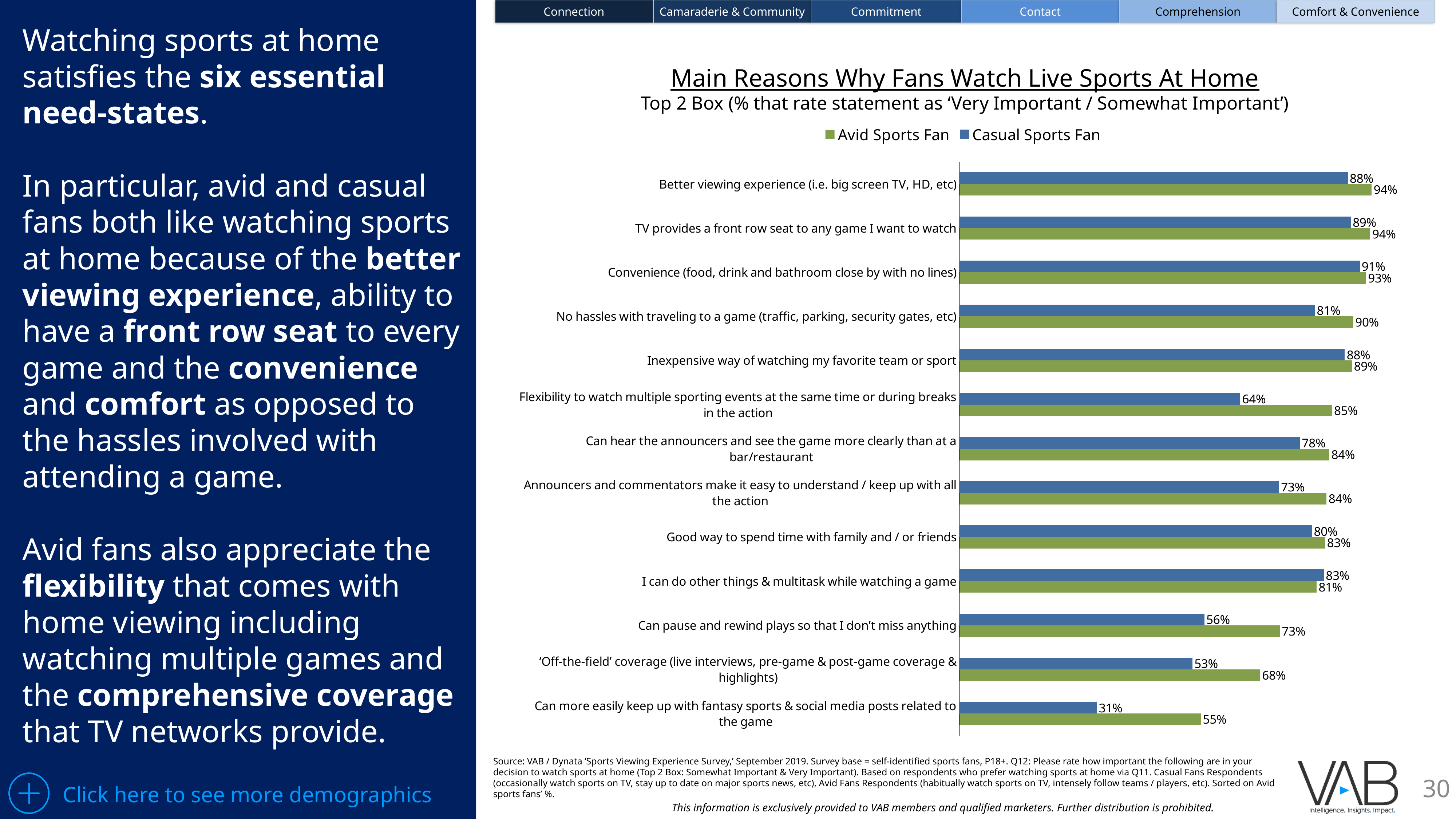
Which reason has the highest value for Casual Sports Fans? Convenience (food, drink and bathroom close by with no lines) Which colour represents Avid Sports Fans in the chart? green Which reason has the lowest value for Casual Sports Fans? Can more easily keep up with fantasy sports & social media posts related to the game What percentage of Avid Sports Fans rate 'No hassles with traveling to a game' as important? 90% How many series does the legend list? 2 For 'I can do other things & multitask while watching a game', which group has the higher value, Avid Sports Fans or Casual Sports Fans? Casual Sports Fan What percentage of Casual Sports Fans rate 'Can pause and rewind plays so that I don't miss anything' as important? 56% How many reasons (categories) are plotted in the chart? 13 Which reason has the lowest value for Avid Sports Fans? Can more easily keep up with fantasy sports & social media posts related to the game What kind of chart is shown on the slide? bar chart What is the difference between Avid and Casual Sports Fans for 'Can more easily keep up with fantasy sports & social media posts related to the game'? 24% What is the Casual Sports Fan value for 'Flexibility to watch multiple sporting events at the same time or during breaks in the action'? 64%